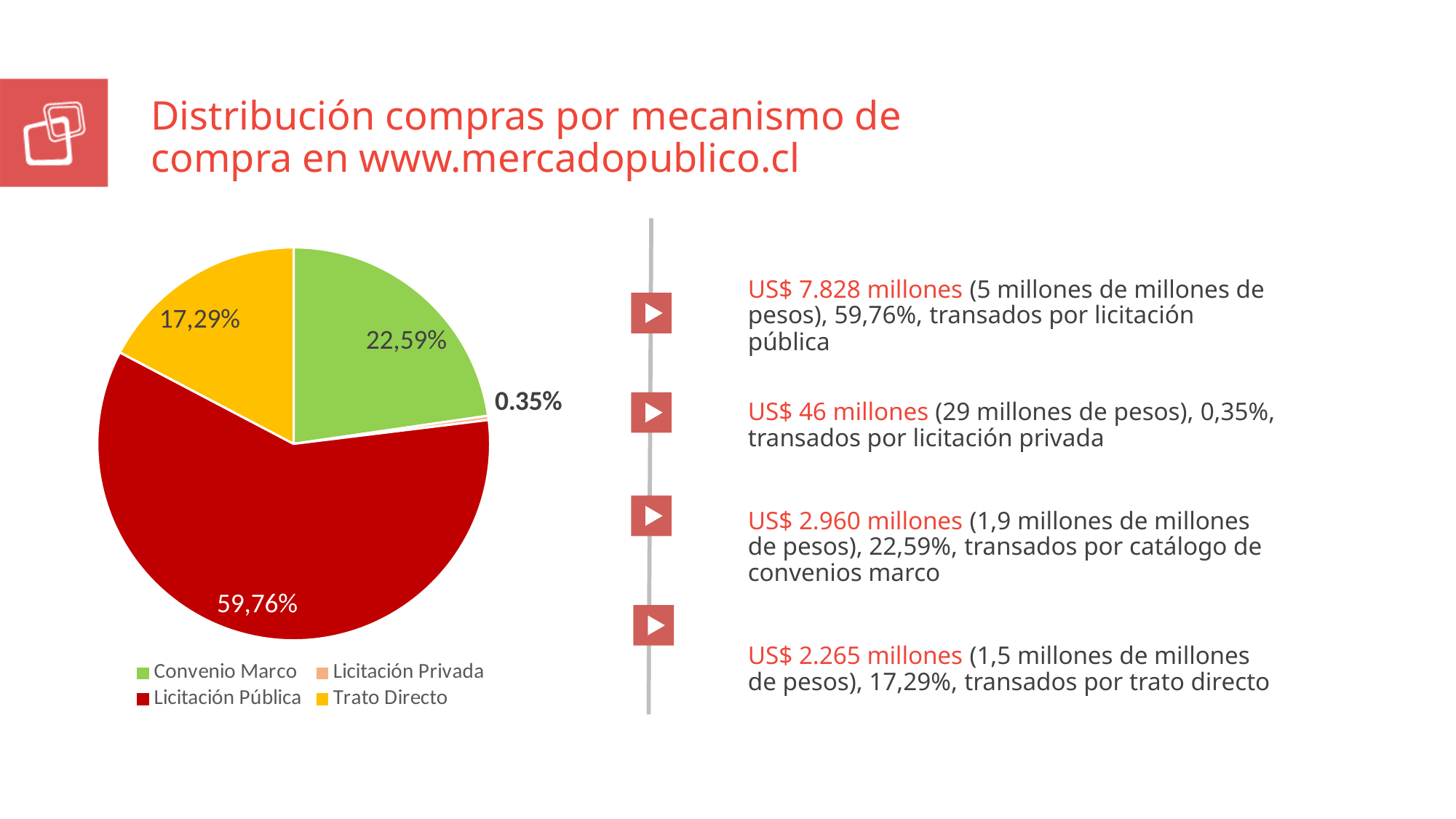
Which legend entry is shown in dark red? Licitación Pública What share of the pie does Licitación Privada have? 0.35% What share of the pie does Trato Directo have? 17,29% What kind of chart is shown on the slide? pie chart How many categories does the pie chart show? 4 What share of the pie does Convenio Marco have? 22,59% Which category has the smallest slice of the pie? Licitación Privada Which is larger, the slice for Convenio Marco or the slice for Trato Directo? Convenio Marco Which category has the largest slice of the pie? Licitación Pública What is the difference in percentage points between the Convenio Marco slice and the Trato Directo slice? 5,30% What colour is the Trato Directo slice in the pie chart? yellow